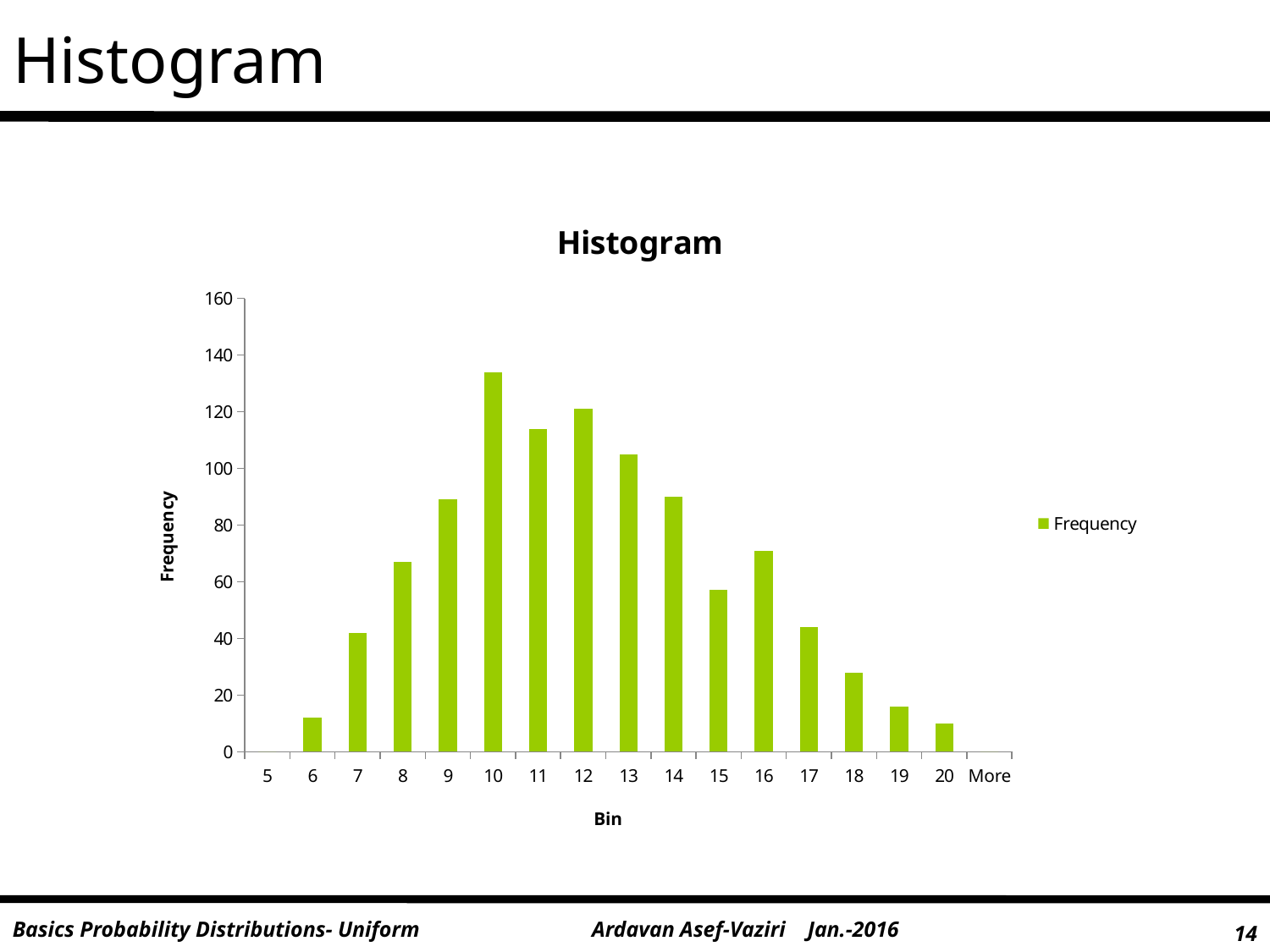
Is the frequency for bin 6 greater or less than 20? less Is the frequency for bin 10 greater or less than 120? greater Is the frequency for bin 12 greater or less than 100? greater How many series does the legend list? 1 Among the bins from 6 to 20, which bin has the shortest bar? 20 Which bin has the tallest bar in the histogram? 10 Do the frequencies rise or fall from bin 6 to bin 10? rise Which bin has the higher frequency, bin 10 or bin 11? 10 How many bin categories are labelled on the x axis? 17 Which bin has the higher frequency, bin 15 or bin 16? 16 What kind of chart is shown on the slide? bar chart